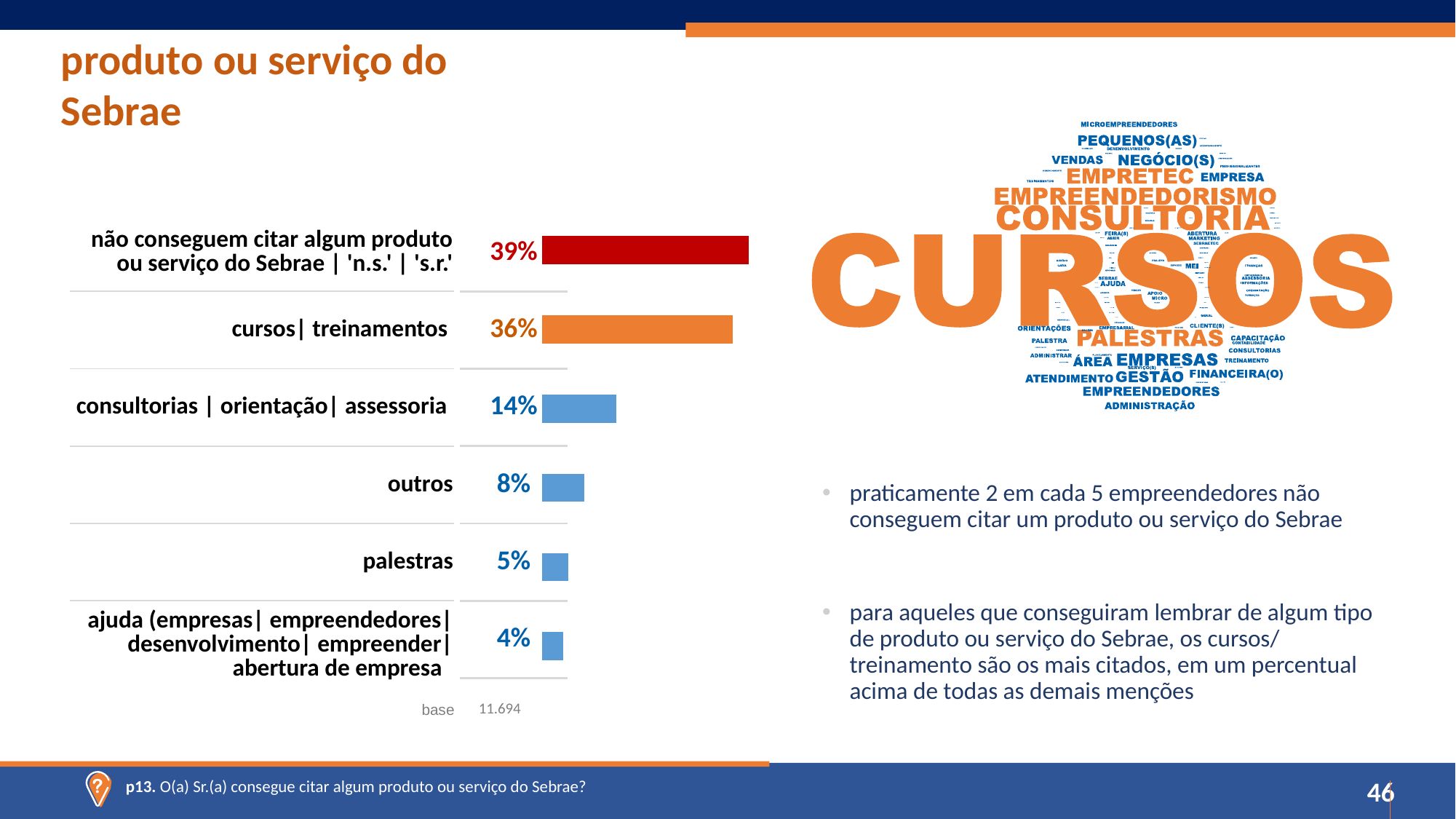
How many categories are shown in the bar chart? 6 What percentage of respondents could not cite any Sebrae product or service ('não conseguem citar algum produto ou serviço do Sebrae')? 39% What kind of chart is shown on the slide? bar chart Which is larger: the value for 'outros' or the value for 'palestras'? outros Which category has the highest value in the bar chart? não conseguem citar algum produto ou serviço do Sebrae | 'n.s.' | 's.r.' What is the value shown for 'palestras'? 5% What is the value shown for 'consultorias | orientação| assessoria'? 14% What is the difference between the values for 'cursos| treinamentos' and 'consultorias | orientação| assessoria'? 22% Which category has the lowest value in the bar chart? ajuda (empresas| empreendedores| desenvolvimento| empreender| abertura de empresa) What is the base (number of respondents) shown below the chart? 11.694 What is the value shown for 'cursos| treinamentos'? 36% What colour is the bar for 'cursos| treinamentos'? orange